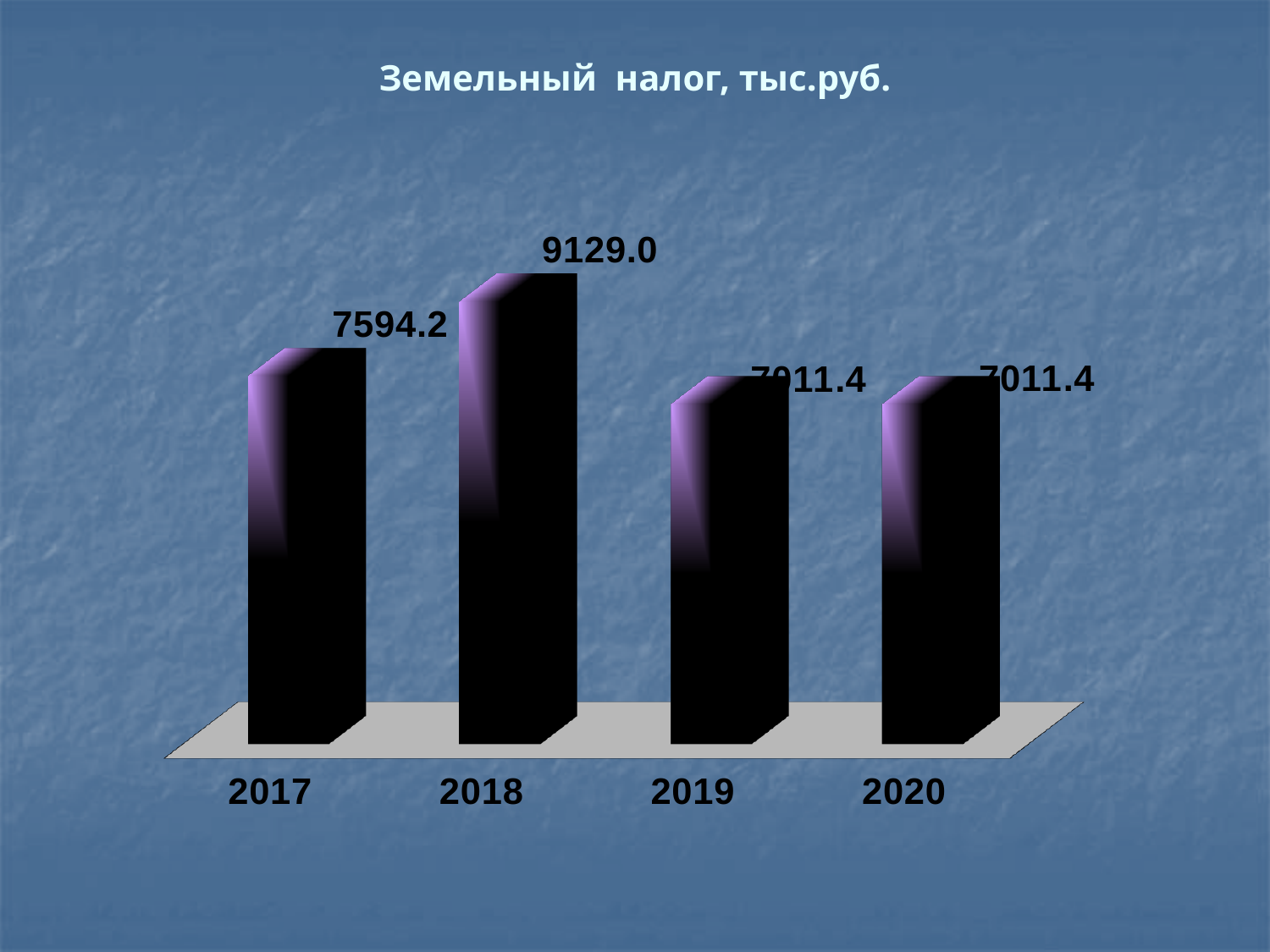
Which is larger, the value for 2017 or the value for 2020? 2017 What is the value for 2017? 7594.2 What is the difference between the values for 2017 and 2019? 582.8 What is the value for 2019? 7011.4 Which year has the highest value? 2018 What is the value for 2020? 7011.4 Which years have the lowest value? 2019 and 2020 What is the difference between the values for 2018 and 2017? 1534.8 What kind of chart is shown on the slide? bar chart What is the value for 2018? 9129.0 What is the title of the chart? Земельный налог, тыс.руб. How many years are shown on the chart? 4